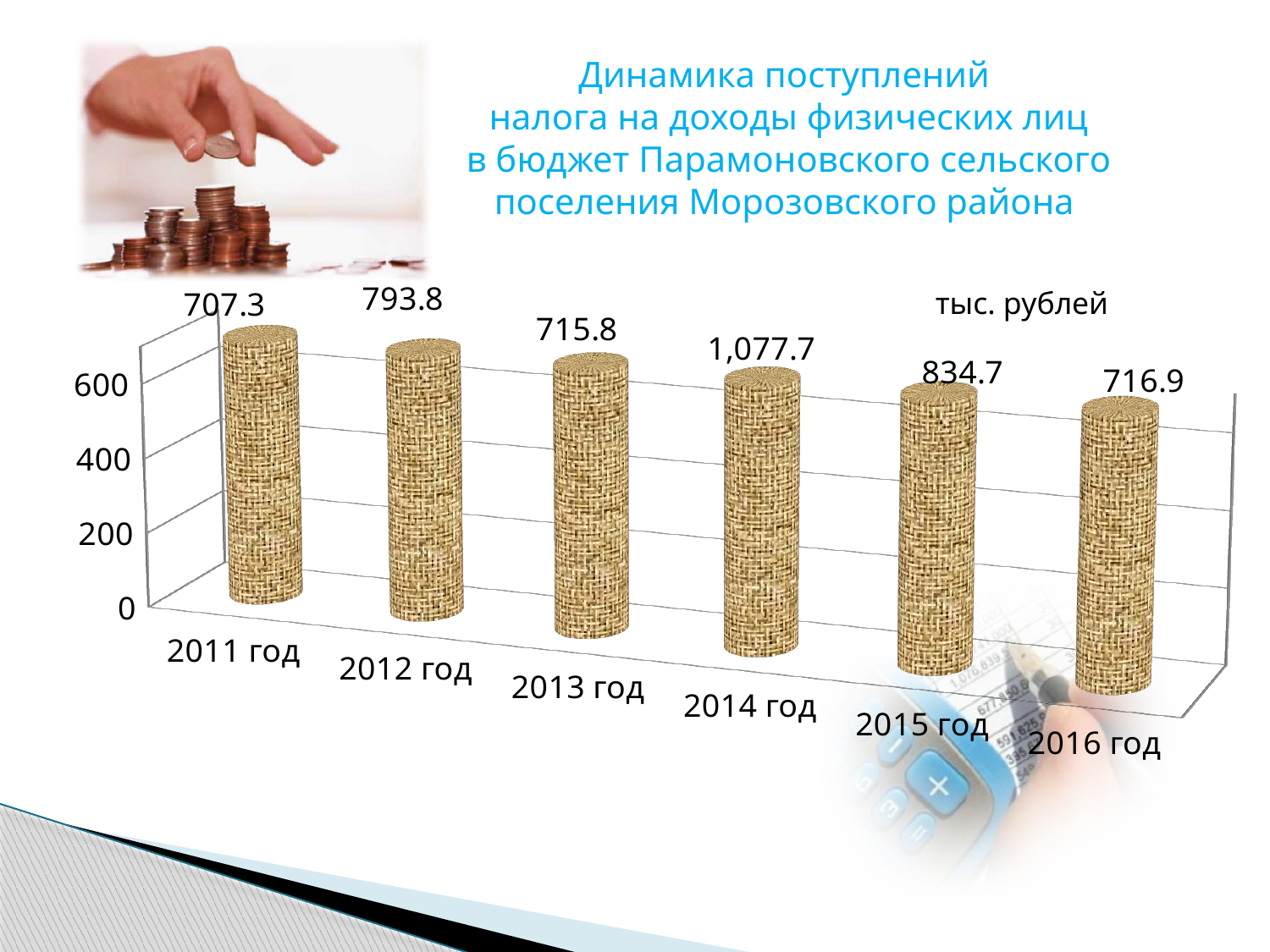
Which year has the highest value? 2014 год Is the value for 2013 год greater or less than 600? greater What is the value for 2015 год? 834.7 How many years are shown on the chart? 6 What is the value for 2011 год? 707.3 From 2014 год to 2016 год, do the values rise or fall? fall What kind of chart is shown on the slide? bar chart What is the value for 2014 год? 1,077.7 Which is larger, the value for 2012 год or the value for 2015 год? 2015 год What is the difference between the values for 2015 год and 2016 год? 117.8 Which year has the lowest value? 2011 год What is the difference between the values for 2014 год and 2011 год? 370.4